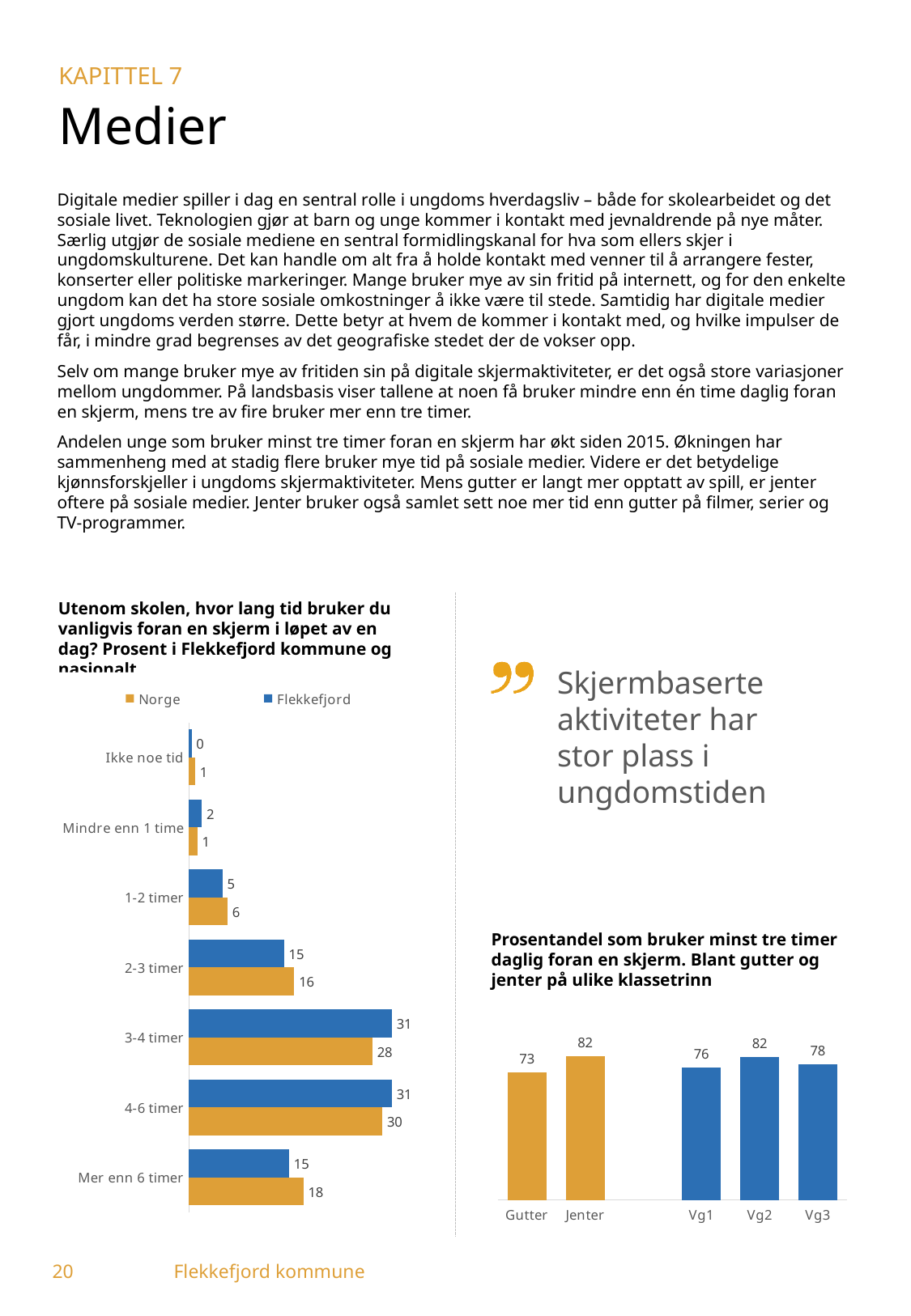
In the chart 'Utenom skolen, hvor lang tid bruker du vanligvis foran en skjerm i løpet av en dag?', what is the difference between the Norge and Flekkefjord values for '2-3 timer'? 1 What kind of chart is 'Utenom skolen, hvor lang tid bruker du vanligvis foran en skjerm i løpet av en dag?'? Bar chart In the chart 'Utenom skolen, hvor lang tid bruker du vanligvis foran en skjerm i løpet av en dag?', how many categories are shown? 7 In the chart 'Prosentandel som bruker minst tre timer daglig foran en skjerm', what is the value for Gutter? 73 In the chart 'Prosentandel som bruker minst tre timer daglig foran en skjerm', how many bars are shown? 5 In the chart 'Prosentandel som bruker minst tre timer daglig foran en skjerm', which of Vg1, Vg2 and Vg3 has the highest value? Vg2 In the chart 'Prosentandel som bruker minst tre timer daglig foran en skjerm', what is the difference between Jenter and Gutter? 9 In the chart 'Utenom skolen, hvor lang tid bruker du vanligvis foran en skjerm i løpet av en dag?', what is the Norge value for 'Mer enn 6 timer'? 18 In the chart 'Utenom skolen, hvor lang tid bruker du vanligvis foran en skjerm i løpet av en dag?', what is the Flekkefjord value for '3-4 timer'? 31 In the chart 'Utenom skolen, hvor lang tid bruker du vanligvis foran en skjerm i løpet av en dag?', how many series does the legend list? 2 In the chart 'Utenom skolen, hvor lang tid bruker du vanligvis foran en skjerm i løpet av en dag?', which category has the lowest Flekkefjord value? Ikke noe tid In the chart 'Utenom skolen, hvor lang tid bruker du vanligvis foran en skjerm i løpet av en dag?', which is larger for 'Mer enn 6 timer': Norge or Flekkefjord? Norge